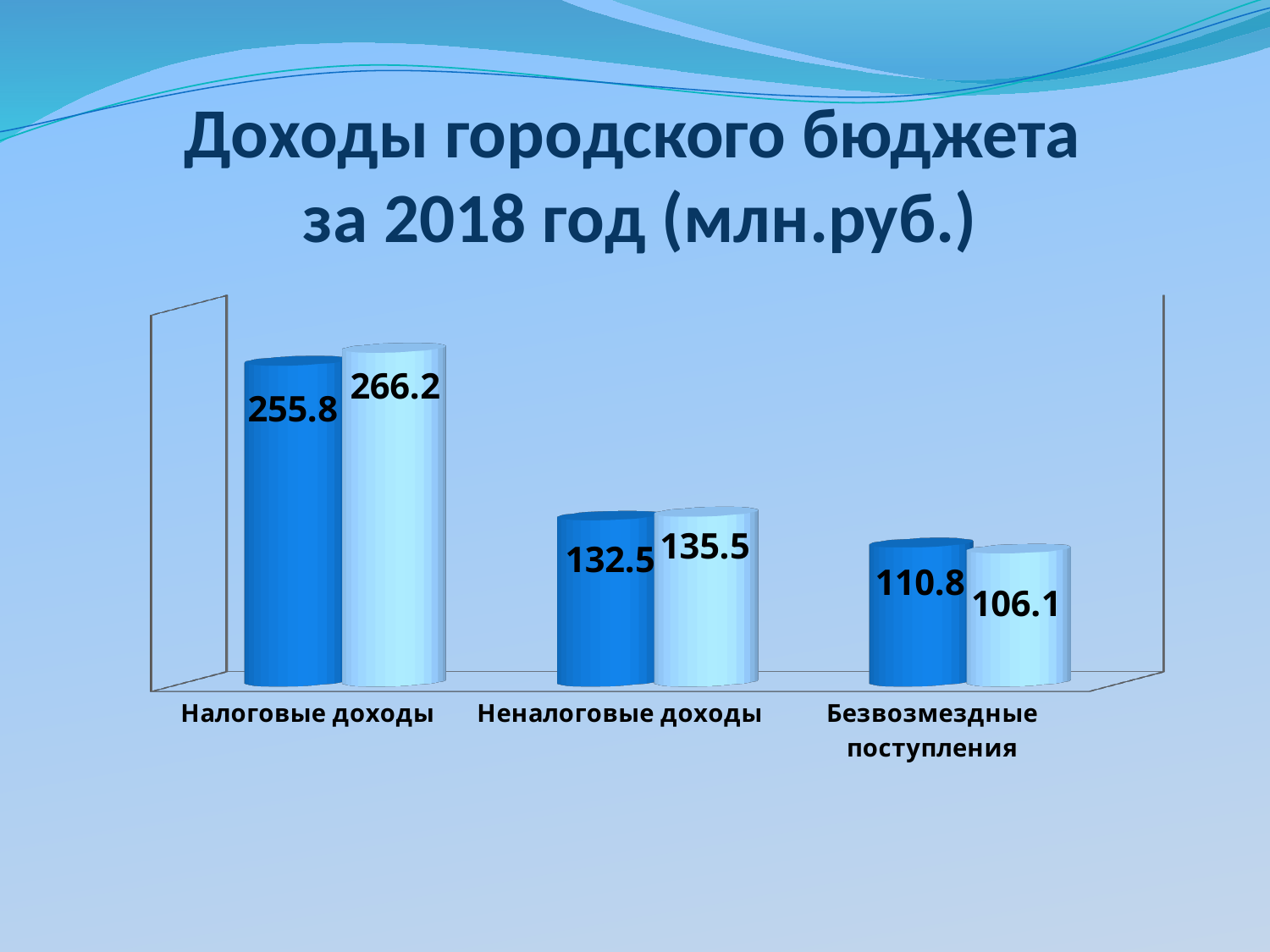
Which category has the lowest dark blue bar? Безвозмездные поступления What is the title of the chart? Доходы городского бюджета за 2018 год (млн.руб.) What kind of chart is shown on the slide? bar chart What is the value of the light blue bar for Безвозмездные поступления? 106.1 What is the difference between the light blue and dark blue bars for Налоговые доходы? 10.4 What is the value of the dark blue bar for Налоговые доходы? 255.8 How many categories are shown on the x axis? 3 What is the value of the light blue bar for Налоговые доходы? 266.2 For Безвозмездные поступления, which bar is larger, the dark blue or the light blue? dark blue What is the difference between the dark blue and light blue bars for Безвозмездные поступления? 4.7 What is the value of the dark blue bar for Неналоговые доходы? 132.5 Which category has the highest values on the chart? Налоговые доходы